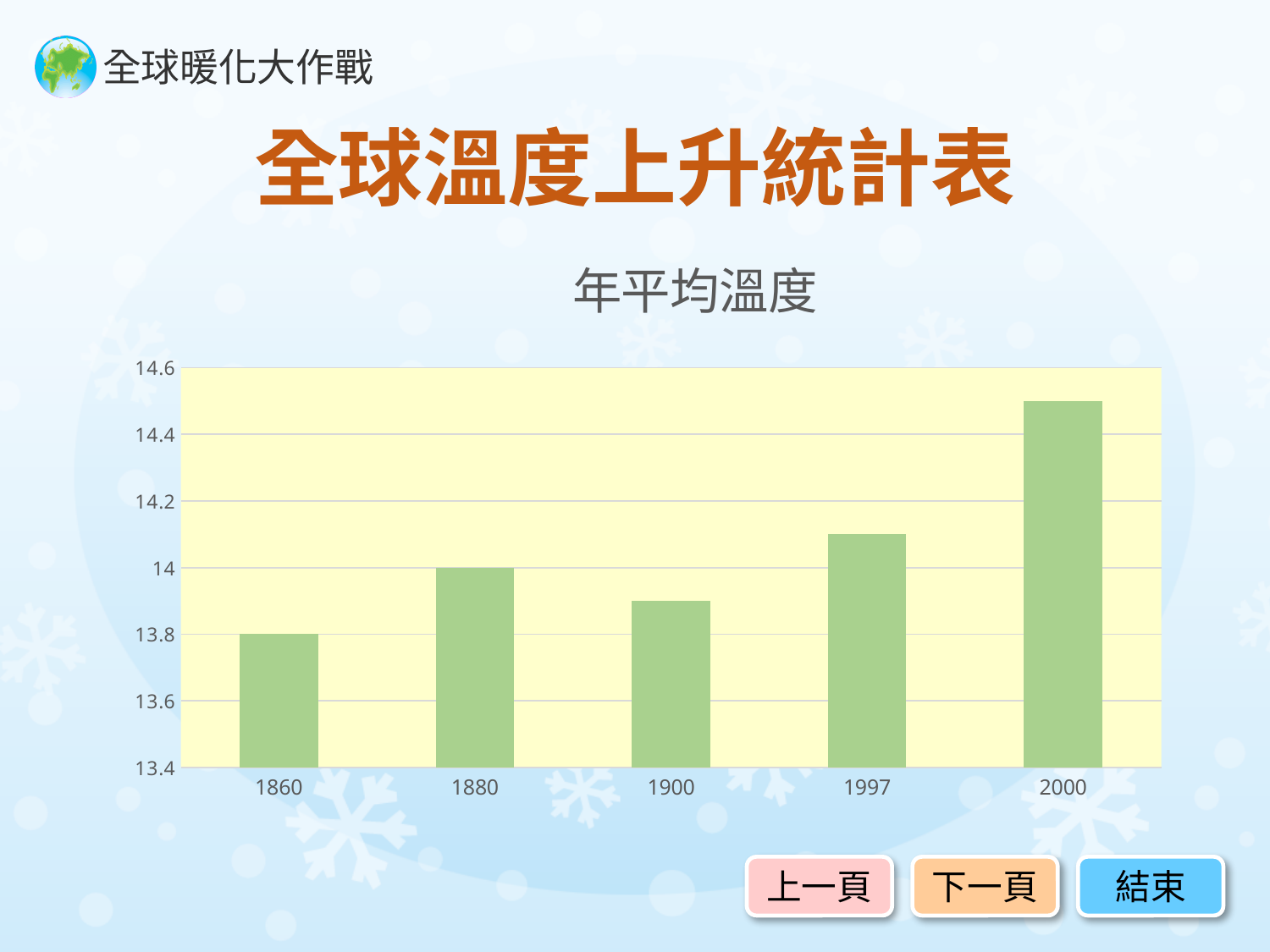
Is the value for 1900 greater or less than 14? less Which is larger, the value for 2000 or the value for 1997? 2000 Overall, do the values rise or fall from 1860 to 2000? rise Is the value for 2000 greater or less than 14.4? greater What is the title of the chart? 年平均溫度 How many years (categories) are shown on the x axis? 5 Which year has the highest value? 2000 Which year has the lowest value? 1860 What is the value for 1880? 14 What is the value for 1860? 13.8 What kind of chart is shown on the slide? bar chart What is the difference between the values for 1880 and 1860? 0.2